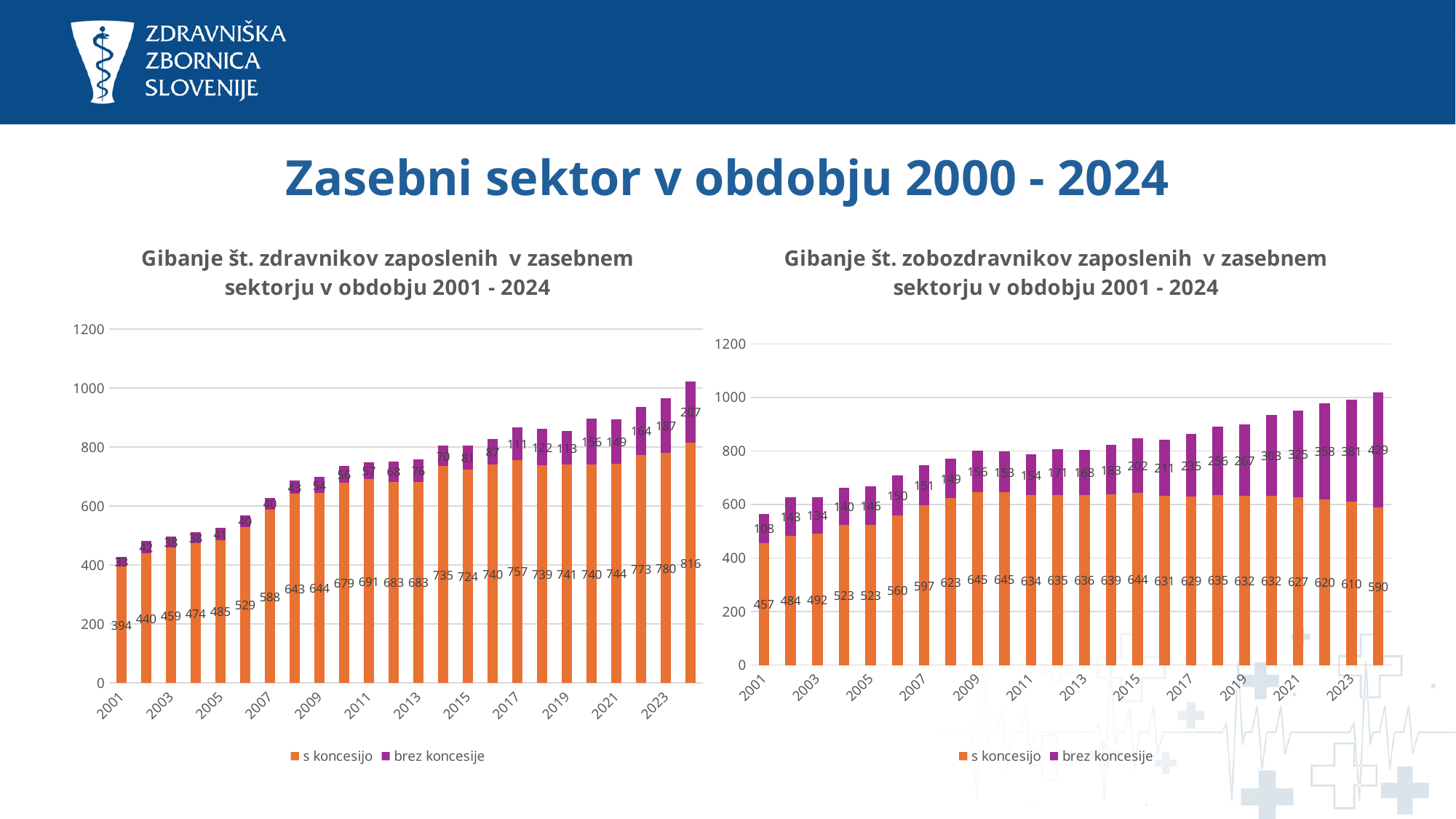
In the left chart (zdravnikov), what is the value for 'brez koncesije' in 2024? 207 In the right chart (zobozdravnikov), what is the difference between the 's koncesijo' values for 2024 and 2001? 133 In the left chart (zdravnikov), which year has the lowest value for 's koncesijo'? 2001 In the right chart (zobozdravnikov), what is the total of the stacked bar for 2024? 1019 In the left chart (zdravnikov), how many series does the legend list? 2 In the left chart (zdravnikov), what is the value for 's koncesijo' in 2024? 816 In the left chart (zdravnikov), which is larger: the 's koncesijo' value for 2017 or for 2018? 2017 In the right chart (zobozdravnikov), what is the value for 'brez koncesije' in 2024? 429 What kind of chart is the right chart (zobozdravnikov)? Stacked bar chart In the left chart (zdravnikov), what is the total height of the stacked bar for 2024? 1023 In the right chart (zobozdravnikov), what is the value for 's koncesijo' in 2001? 457 In the right chart (zobozdravnikov), does the 'brez koncesije' series generally rise or fall from 2001 to 2024? Rise